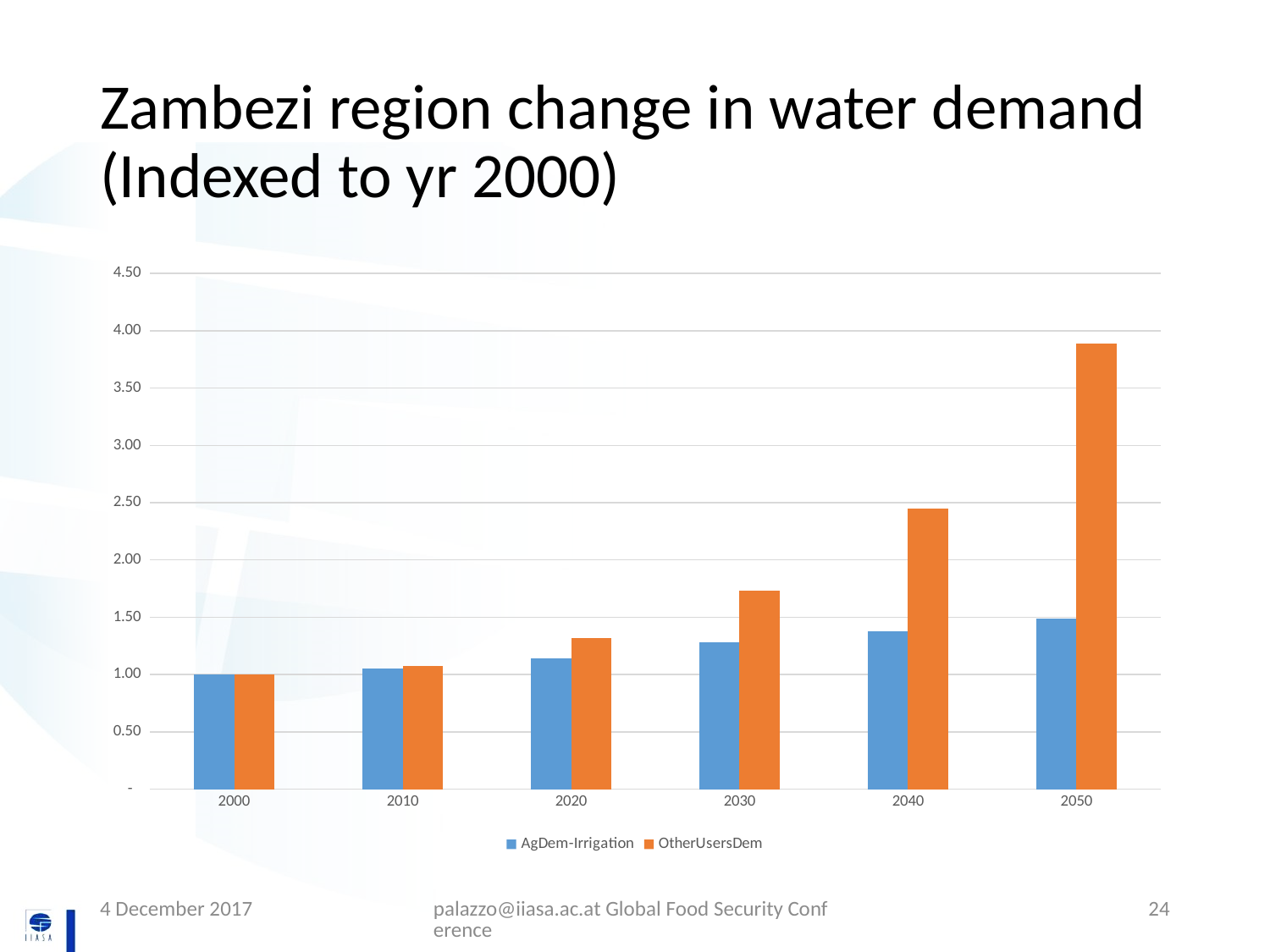
What kind of chart is shown on the slide? Bar chart How many years are shown on the x axis? 6 How many series does the legend list? 2 Which year has the highest value for OtherUsersDem? 2050 Is the value for OtherUsersDem in 2040 greater or less than 2.00? greater What is the value for AgDem-Irrigation in 2000? 1.00 Do the values for OtherUsersDem rise or fall from 2000 to 2050? Rise Which year has the lowest value for OtherUsersDem? 2000 What is the value for OtherUsersDem in 2000? 1.00 In 2050, which series has the larger value, AgDem-Irrigation or OtherUsersDem? OtherUsersDem Is the value for AgDem-Irrigation in 2040 greater or less than 1.50? less Is the value for OtherUsersDem in 2050 greater or less than 3.50? greater